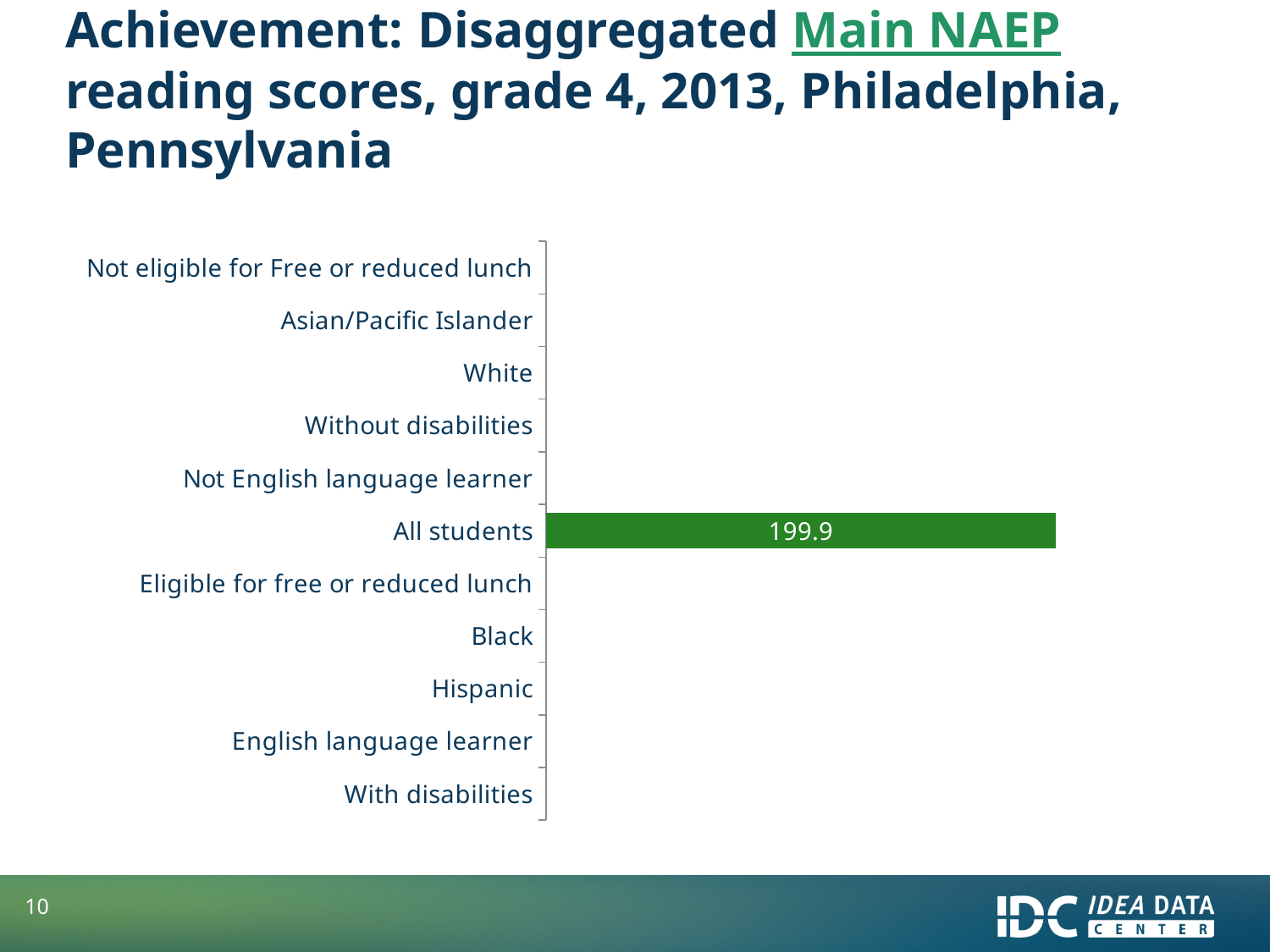
How many categories are listed on the vertical axis of the chart? 11 Which category appears at the top of the vertical axis? Not eligible for Free or reduced lunch What kind of chart is shown on the slide? bar chart Is the value for All students greater or less than 150? greater What is the value shown for All students? 199.9 Which category is the only one with a bar plotted on the chart? All students What colour is the bar for All students? green